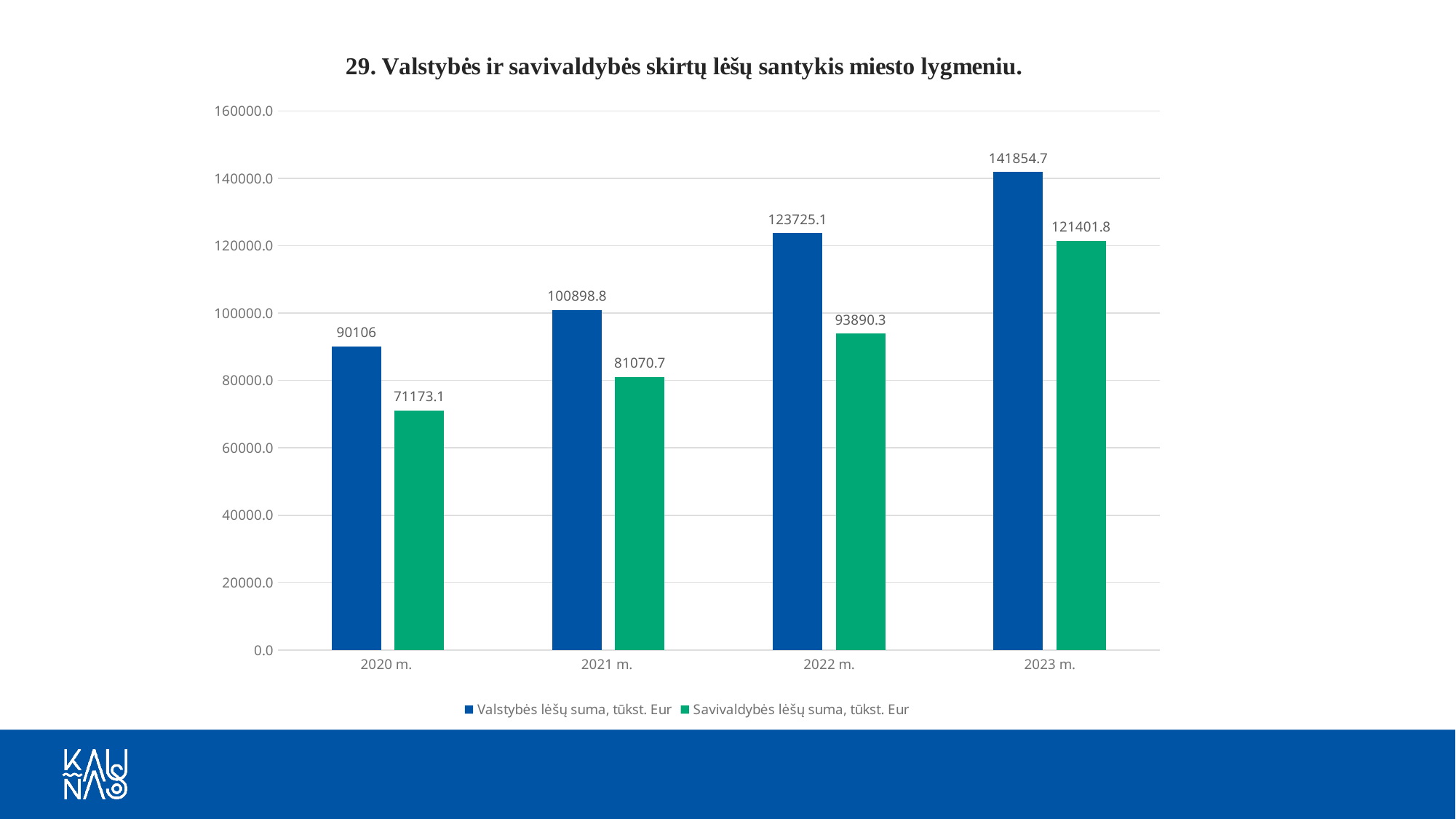
What is the value of Savivaldybės lėšų suma, tūkst. Eur for 2023 m.? 121401.8 What is the difference between Valstybės lėšų suma and Savivaldybės lėšų suma in 2023 m.? 20452.9 How many years are shown on the x axis? 4 What is the value of Savivaldybės lėšų suma, tūkst. Eur for 2022 m.? 93890.3 In which year is Savivaldybės lėšų suma, tūkst. Eur the lowest? 2020 m. In which year is Valstybės lėšų suma, tūkst. Eur the highest? 2023 m. What is the value of Valstybės lėšų suma, tūkst. Eur for 2020 m.? 90106 Which is larger in 2021 m.: Valstybės lėšų suma or Savivaldybės lėšų suma? Valstybės lėšų suma What kind of chart is shown on the slide? Bar chart How many series does the legend list? 2 Does Savivaldybės lėšų suma, tūkst. Eur rise or fall from 2020 m. to 2023 m.? Rise By how much did Valstybės lėšų suma, tūkst. Eur increase from 2020 m. to 2023 m.? 51748.7